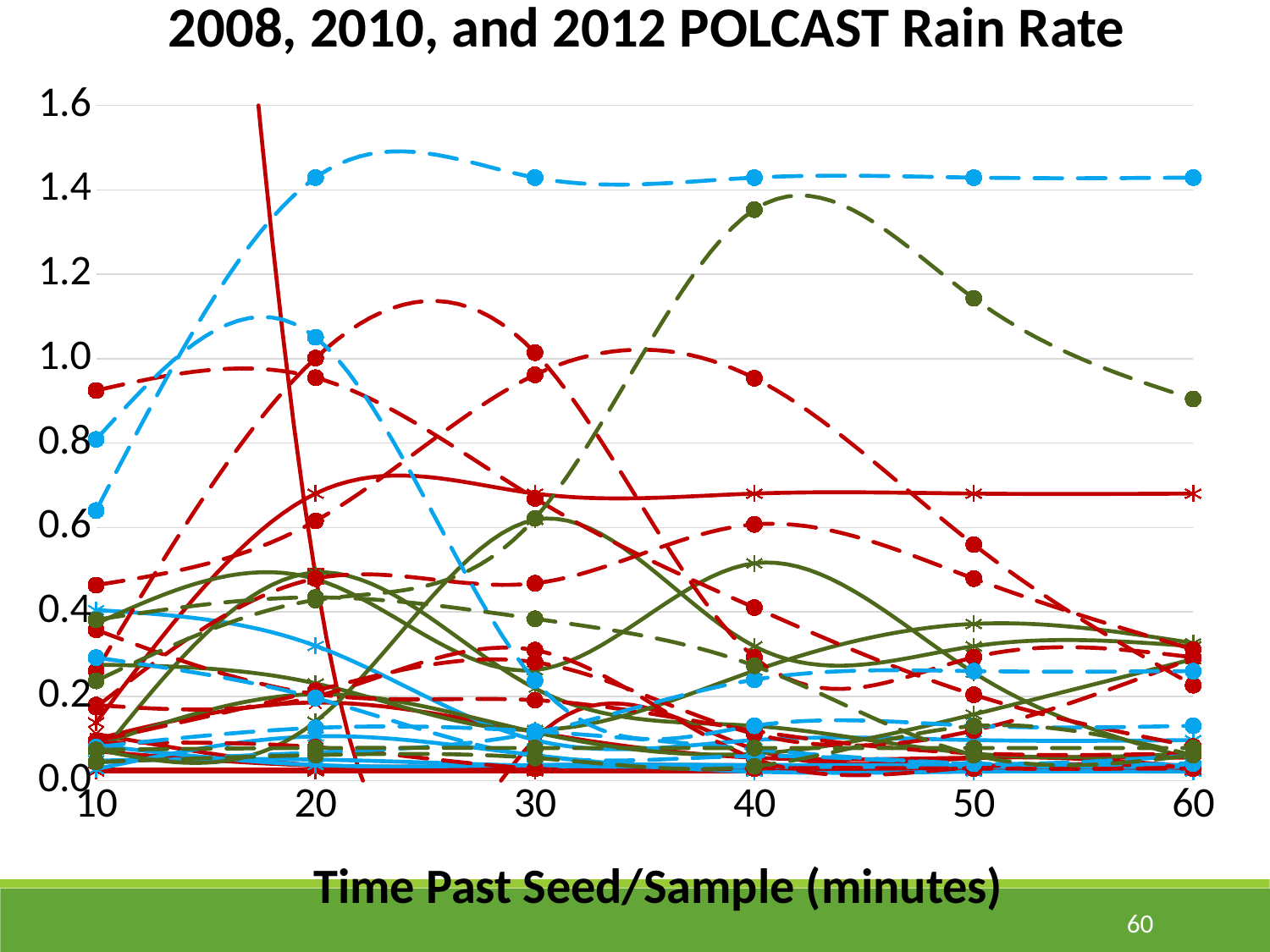
What kind of chart is shown on the slide? line chart Is the highest plotted value at 60 minutes greater or less than 1.2? greater Is the highest green dashed-line value at 40 minutes greater or less than 1.2? greater How many time values are marked along the x axis? 6 What is the label of the x axis? Time Past Seed/Sample (minutes) What is the title of the chart? 2008, 2010, and 2012 POLCAST Rain Rate